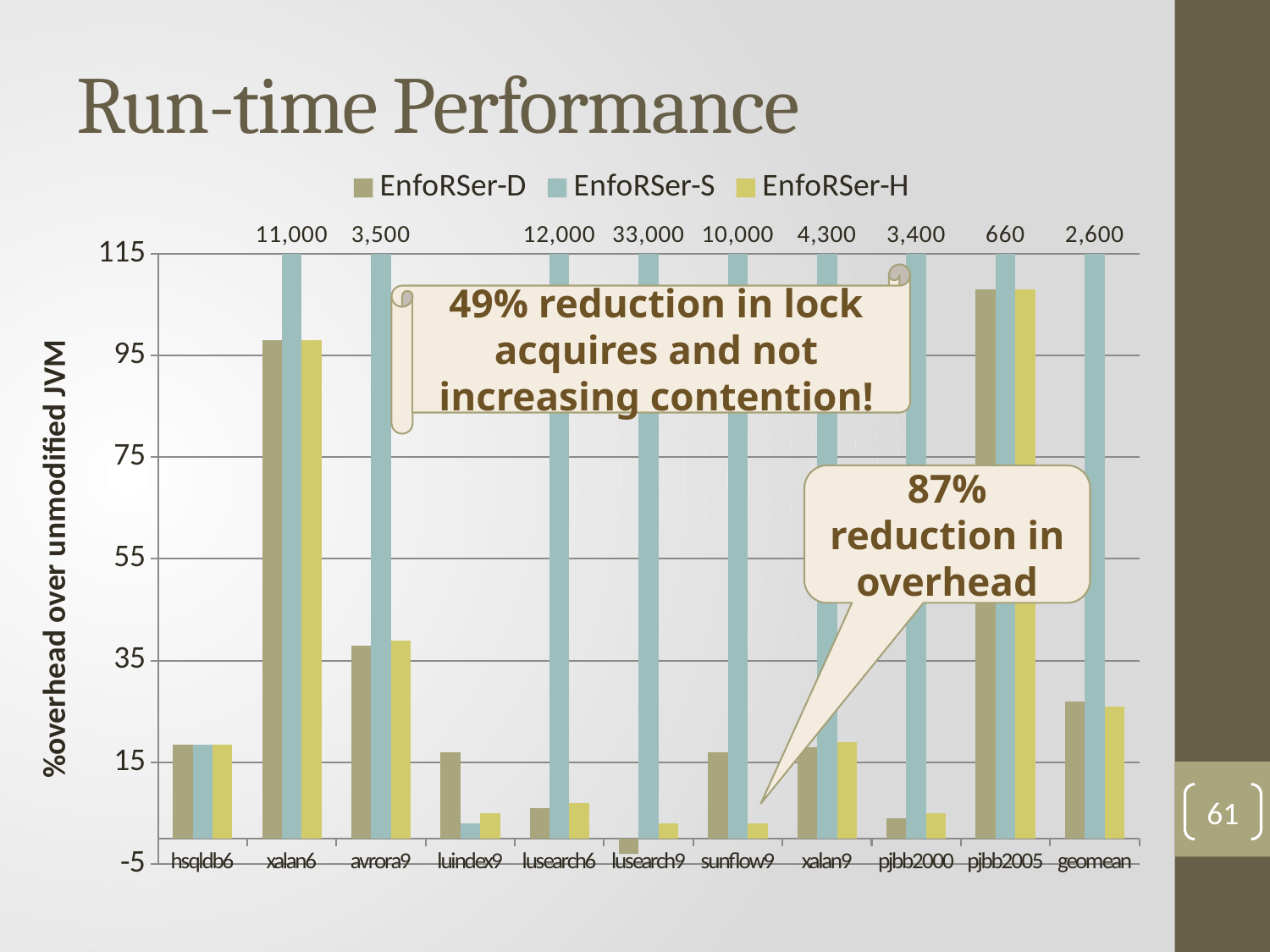
Among the EnfoRSer-S values printed above the chart, which benchmark has the highest value? lusearch9 Which is larger, the printed EnfoRSer-S value for xalan6 or for avrora9? xalan6 What is the label on the vertical axis? %overhead over unmodified JVM How many categories are shown along the x axis? 11 Among the EnfoRSer-S values printed above the chart, which benchmark has the lowest value? pjbb2005 Is the EnfoRSer-D value for xalan6 greater or less than 95? greater What value is printed for EnfoRSer-S on geomean? 2,600 How many series does the legend list? 3 What value is printed for EnfoRSer-S on lusearch9? 33,000 What is the difference between the printed EnfoRSer-S values for lusearch9 and pjbb2005? 32,340 What value is printed for EnfoRSer-S on pjbb2005? 660 What kind of chart is shown on the slide? bar chart